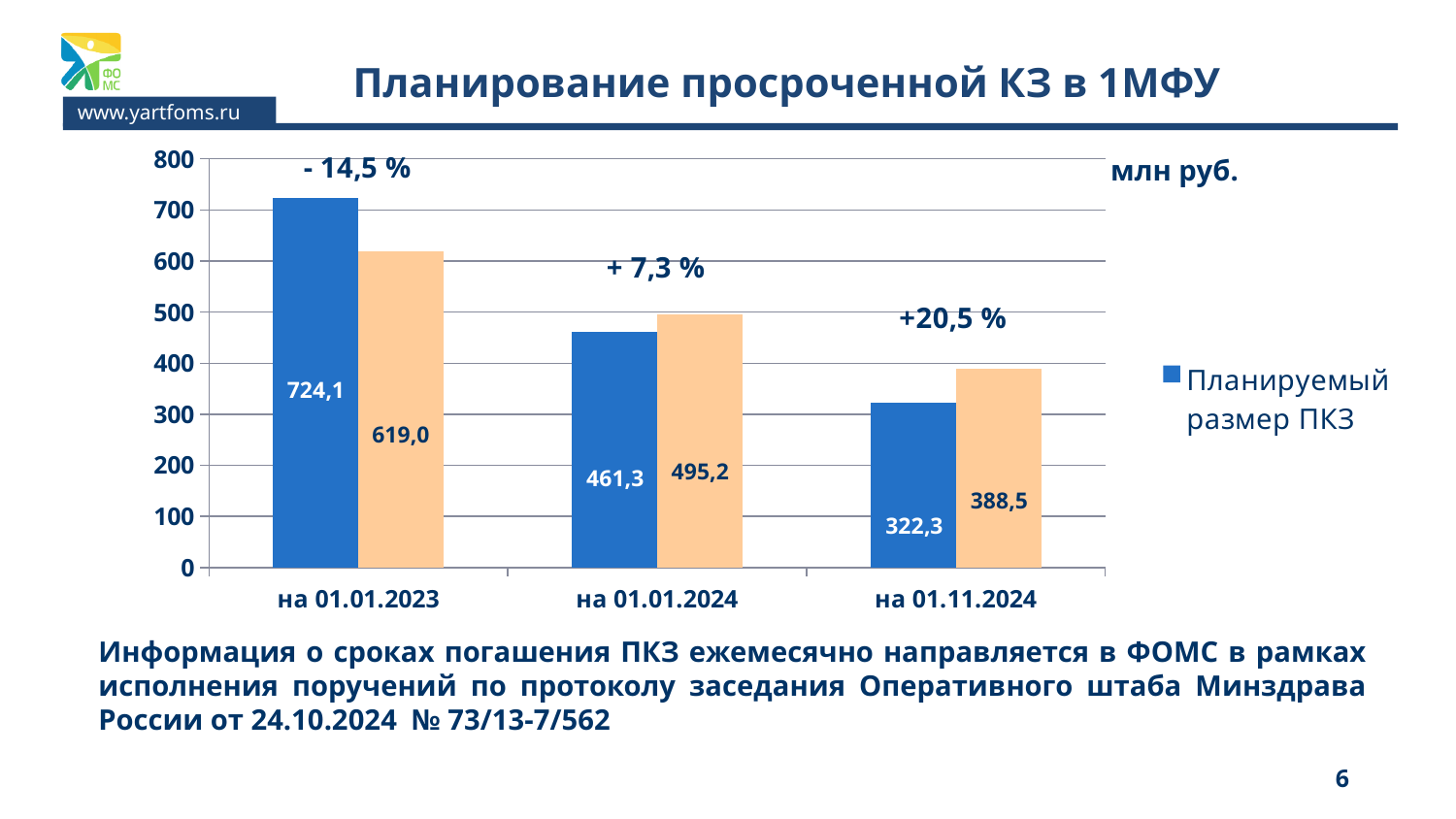
What is the difference between the blue bar and the orange bar на 01.01.2023? 105,1 For which date is Планируемый размер ПКЗ the highest? на 01.01.2023 What type of chart is shown on the slide? Bar chart What is the value of the orange bar на 01.01.2024? 495,2 Which is larger на 01.01.2024: the blue bar (461,3) or the orange bar (495,2)? The orange bar (495,2) What is the difference between the orange bar and the blue bar на 01.11.2024? 66,2 For which date is Планируемый размер ПКЗ the lowest? на 01.11.2024 What is the value of Планируемый размер ПКЗ на 01.11.2024? 322,3 Does Планируемый размер ПКЗ rise or fall from на 01.01.2023 to на 01.11.2024? Fall What is the value of Планируемый размер ПКЗ на 01.01.2023? 724,1 How many dates (categories) are shown on the x axis? 3 How many series does the legend list? 1